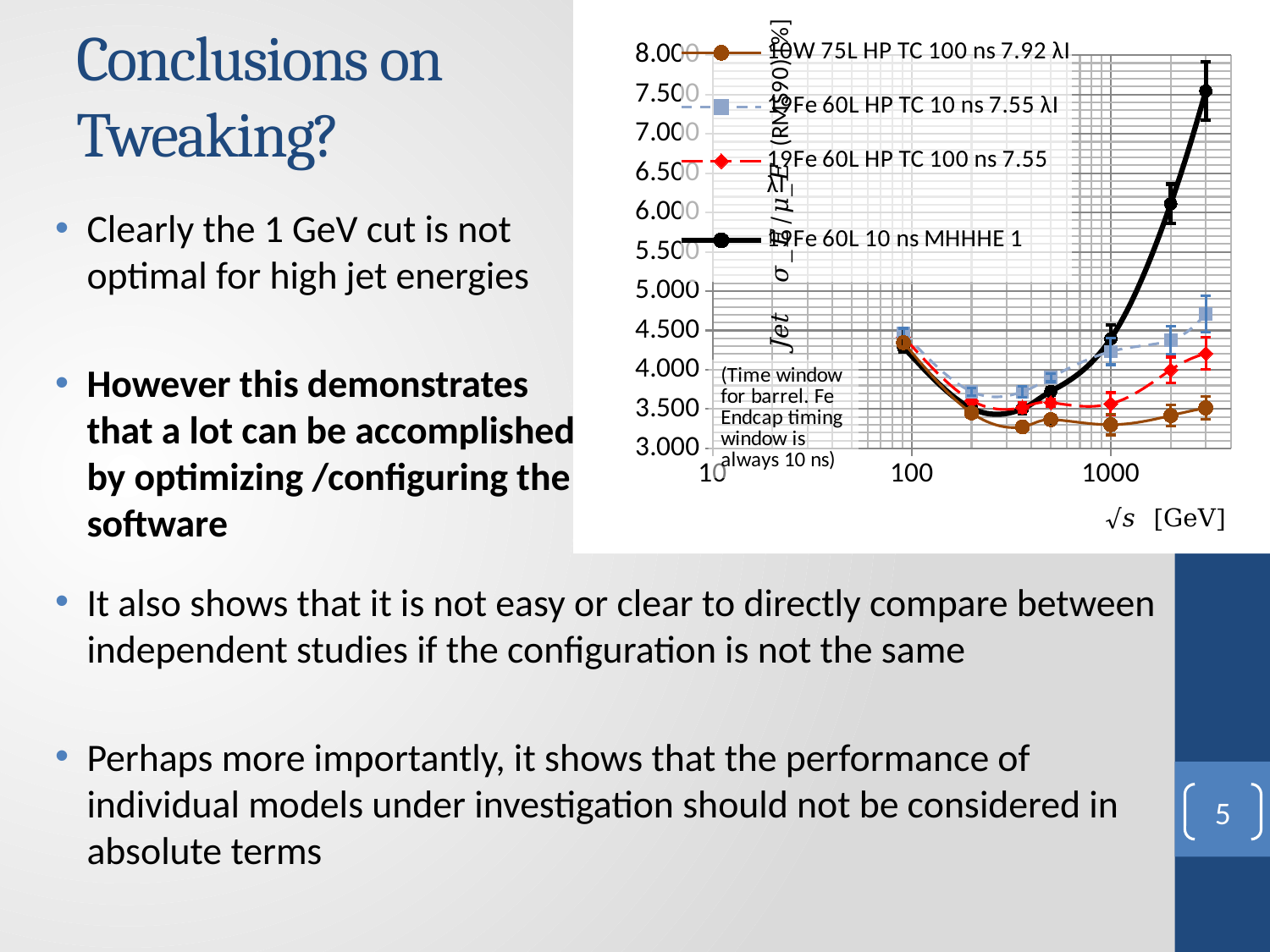
What quantity is shown on the x axis of the chart? √s [GeV] Which series has the lowest value at the highest energy plotted? 10W 75L HP TC 100 ns 7.92 λI Is the lowest value of the 10W 75L HP TC 100 ns 7.92 λI series greater or less than 3.500? less At the highest energy plotted, which is larger: the 19Fe 60L 10 ns MHHHE 1 series or the 19Fe 60L HP TC 10 ns 7.55 λI series? 19Fe 60L 10 ns MHHHE 1 Does the 19Fe 60L 10 ns MHHHE 1 series rise or fall between 1000 GeV and the highest energy plotted? rise Is the value of the 19Fe 60L 10 ns MHHHE 1 series at its highest-energy point greater or less than 7.000? greater What kind of chart is shown on the slide? line chart Which series reaches the highest value at the highest energy plotted? 19Fe 60L 10 ns MHHHE 1 How many series does the chart legend list? 4 Which series is plotted with a solid black line and circle markers? 19Fe 60L 10 ns MHHHE 1 Is the value of the 10W 75L HP TC 100 ns 7.92 λI series at its highest-energy point greater or less than 4.000? less